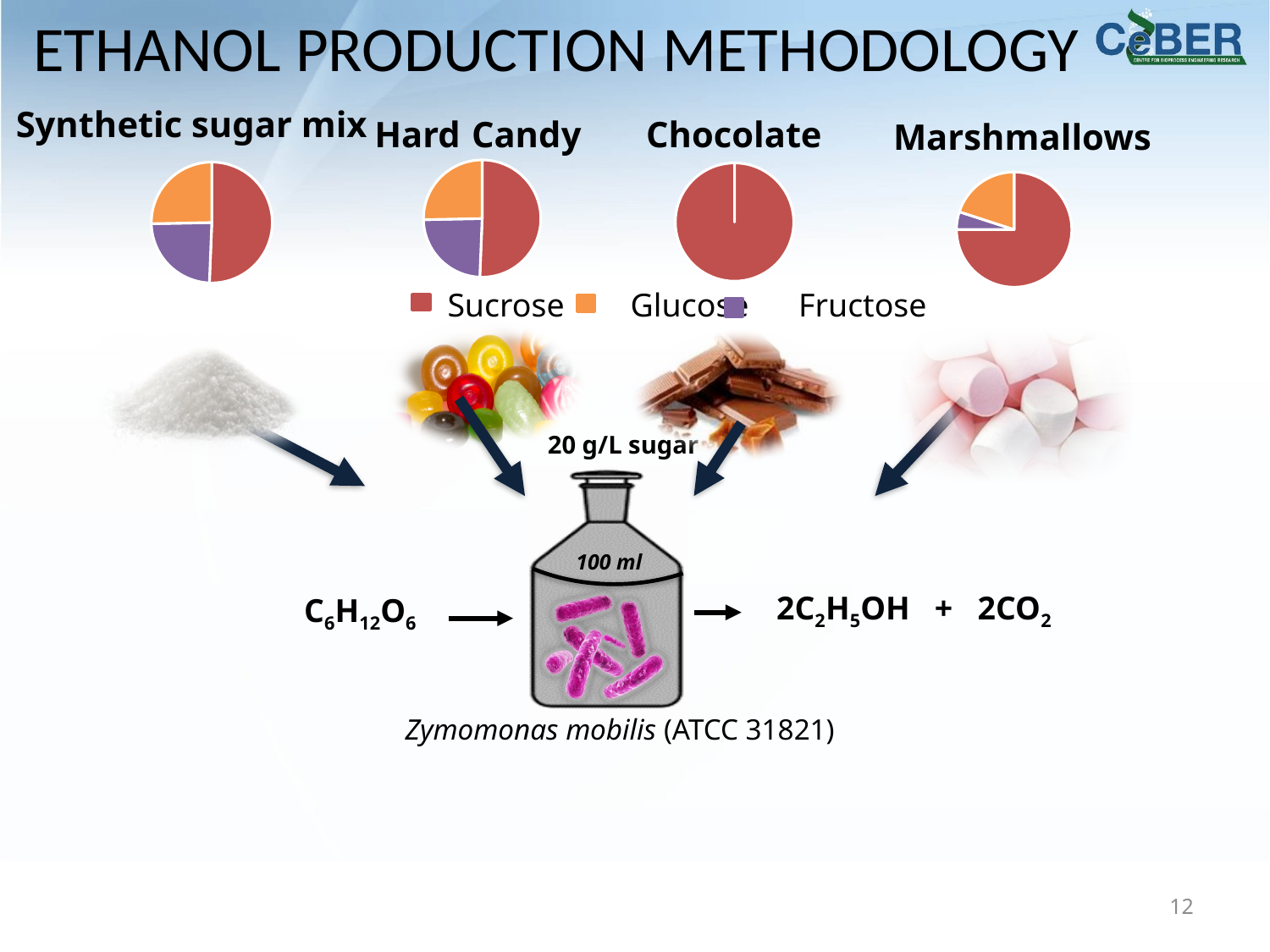
In the Marshmallows pie chart, which slice is larger, Glucose or Fructose? Glucose What colour represents Sucrose in the pie charts? Red In the Marshmallows pie chart, which sugar has the largest slice? Sucrose In the Hard Candy pie chart, which sugar has the largest slice? Sucrose In the Marshmallows pie chart, which sugar has the smallest slice? Fructose Which sugar types are listed in the legend? Sucrose, Glucose, Fructose In the Synthetic sugar mix pie chart, which sugar has the largest slice? Sucrose In the Hard Candy pie chart, which slice is larger, Sucrose or Glucose? Sucrose How many pie charts are shown on the slide? 4 What kind of chart is used for the Synthetic sugar mix? Pie chart How many sugar types does the shared legend list? 3